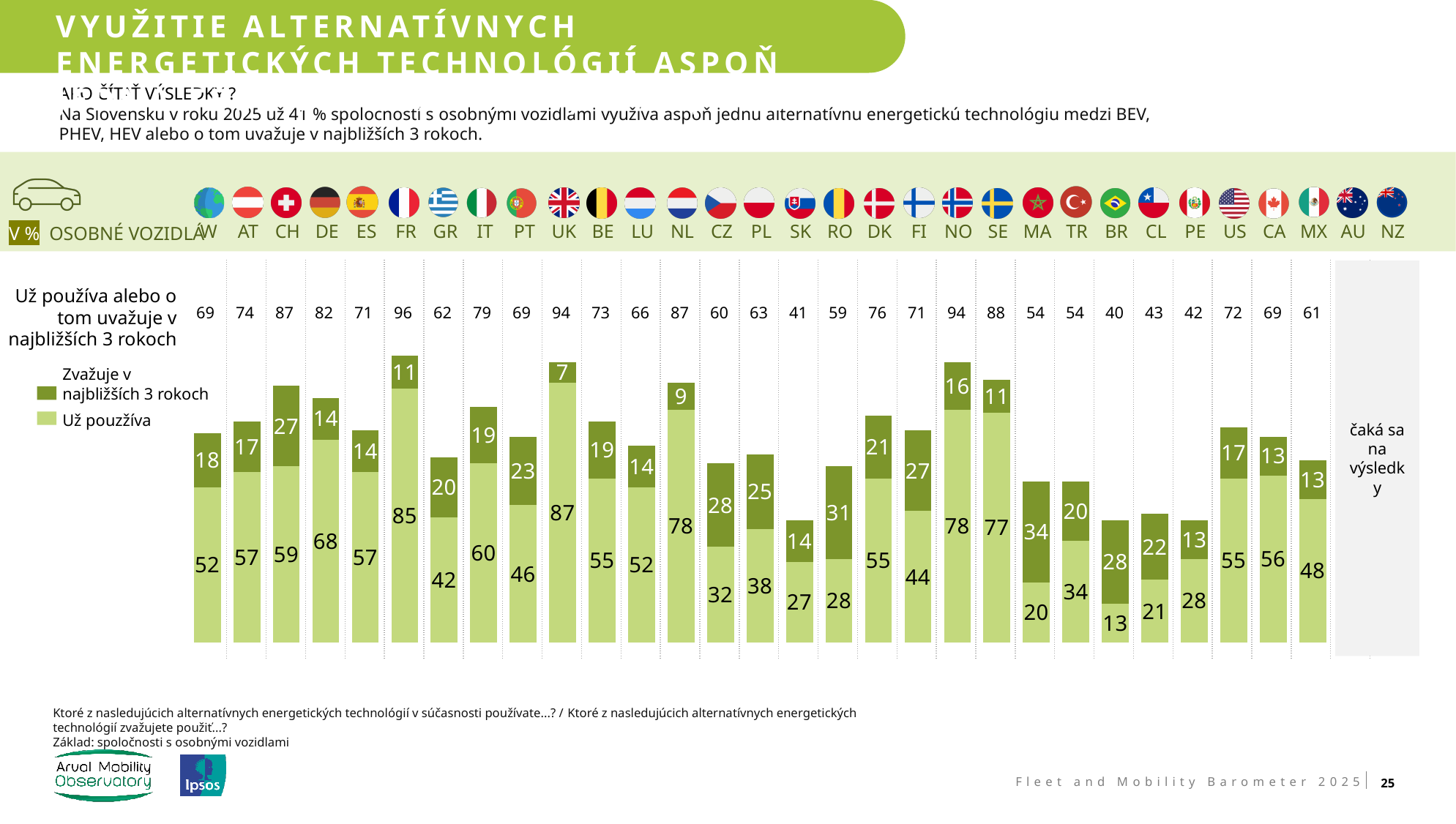
Which has a larger 'Už používa' value, DE or ES? DE What is the 'Už používa' (already uses) value for UK? 87 What is the 'Zvažuje v najbližších 3 rokoch' (considering) value for MA? 34 What is the difference between the total values for FR and BR? 56 What is the total value (already uses or considering in the next 3 years) for SK? 41 Which country has the lowest total value? BR Which country has the highest total value? FR Which country has the lowest 'Už používa' (already uses) value? BR What kind of chart is shown on the slide? Stacked bar chart How many series does the legend list? 2 What is the total of the stacked bar for NO? 94 Which two countries are marked as awaiting results ('čaká sa na výsledky')? AU and NZ